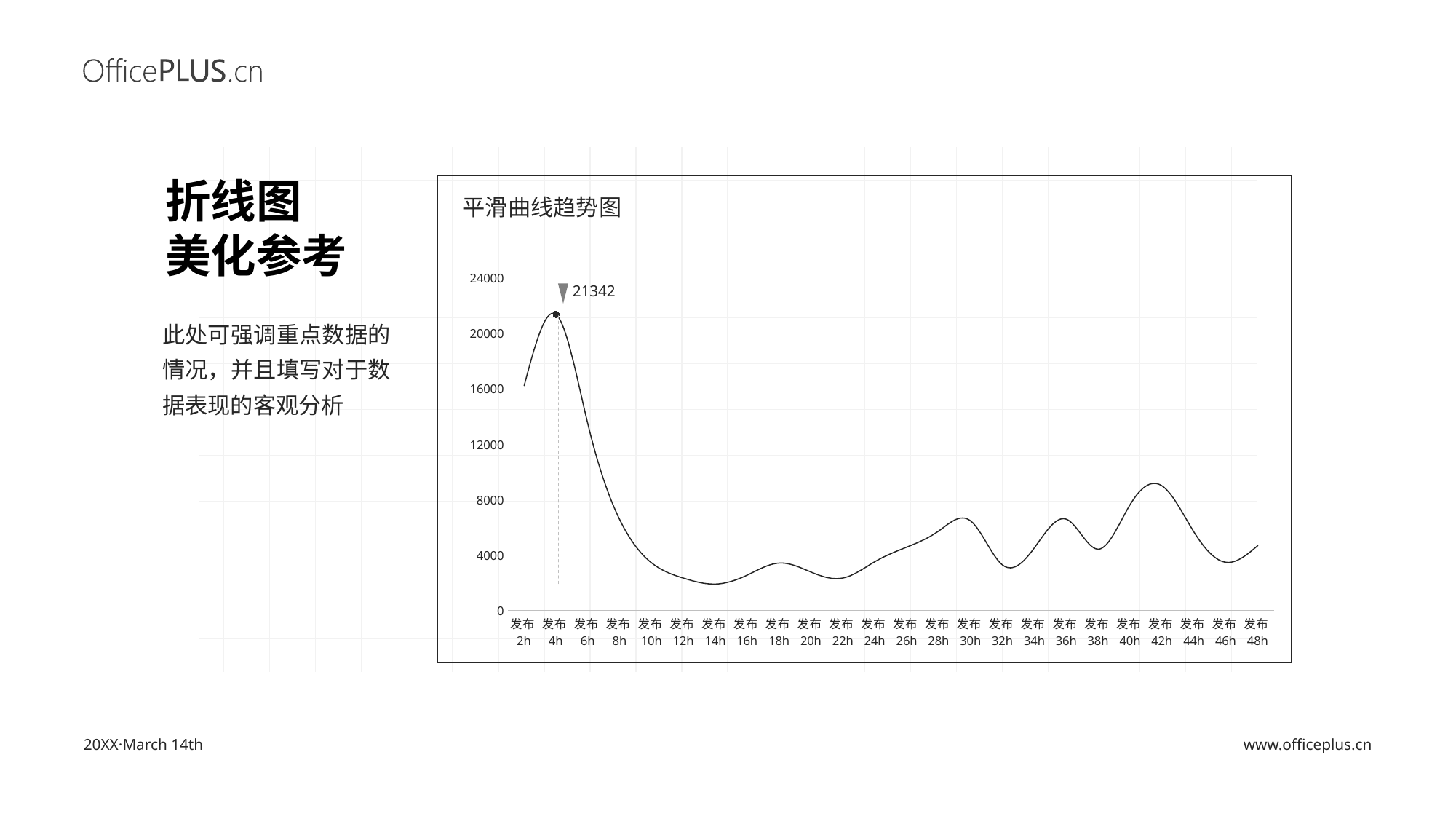
Is the value for 发布2h greater or less than 12000? greater Which category has the highest value? 发布4h What type of chart is shown on the slide? line chart Do the values rise or fall from 发布4h to 发布14h? fall What is the title of the chart? 平滑曲线趋势图 What is the value labelled at 发布4h? 21342 How many categories are shown on the x axis? 24 Is the value for 发布30h greater or less than 8000? less Is the value for 发布14h greater or less than 4000? less Which is larger, the value for 发布42h or the value for 发布30h? 发布42h Which is larger, the value for 发布4h or the value for 发布42h? 发布4h